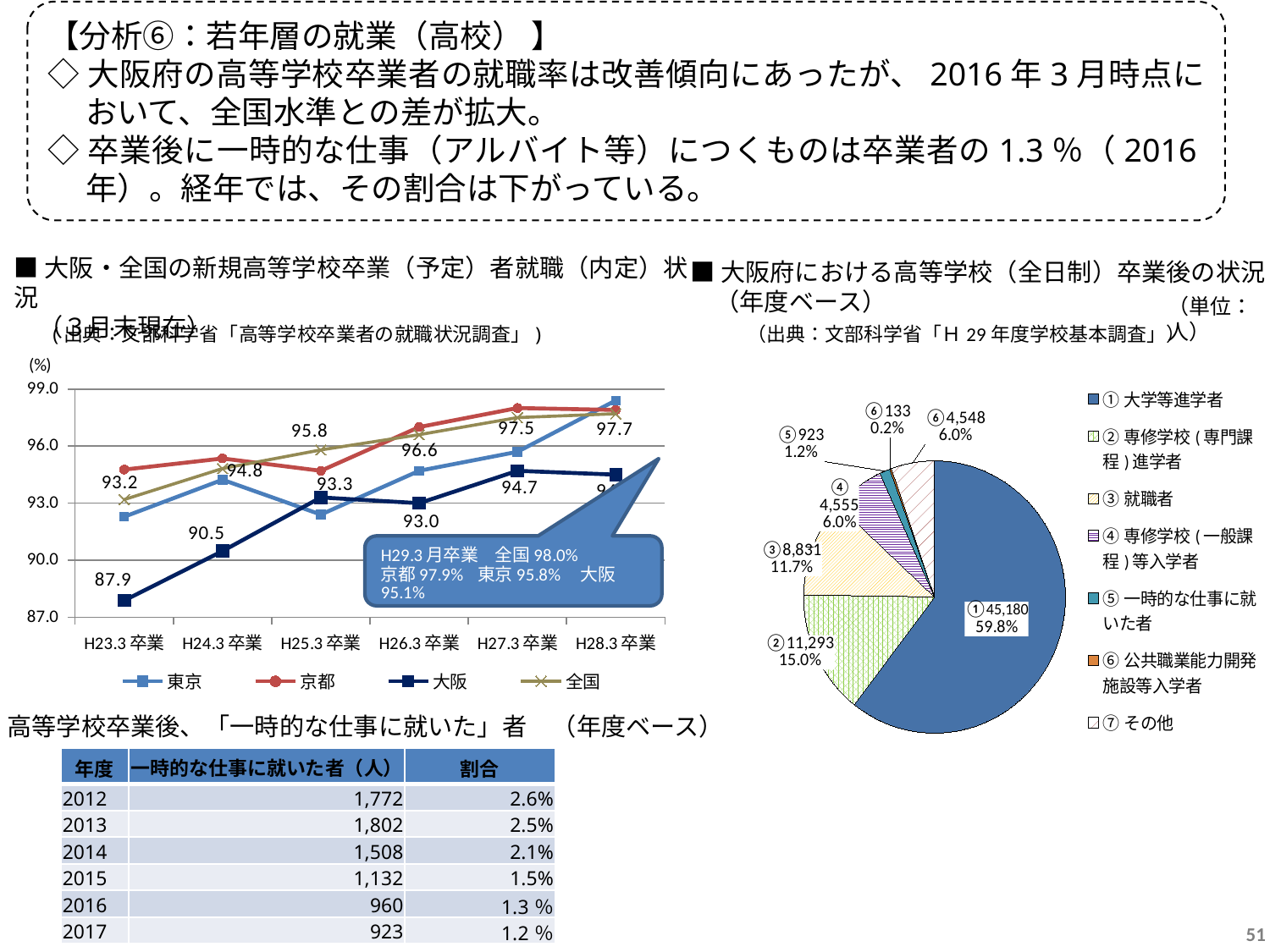
In the line chart on the left, does the 全国 series rise or fall from H23.3卒業 to H28.3卒業? rise In the line chart on the left, what is the value for 全国 at H27.3卒業? 97.5 In the line chart on the left, at which x-axis category is the 大阪 value lowest? H23.3卒業 How many series does the legend of the line chart on the left list? 4 In the pie chart on the right, what is the value for ③就職者? 8,831 In the pie chart on the right (大阪府における高等学校（全日制）卒業後の状況), what share does ①大学等進学者 have? 59.8% How many entries does the legend of the pie chart on the right list? 7 How many x-axis categories does the line chart on the left have? 6 In the line chart on the left, what is the value for 大阪 at H23.3卒業? 87.9 In the line chart on the left, is the value for 東京 at H23.3卒業 greater or less than 93.0? less In the line chart on the left, what is the difference between 全国 and 大阪 at H23.3卒業? 5.3 What kind of chart is the chart on the left (大阪・全国の新規高等学校卒業（予定）者就職（内定）状況)? line chart